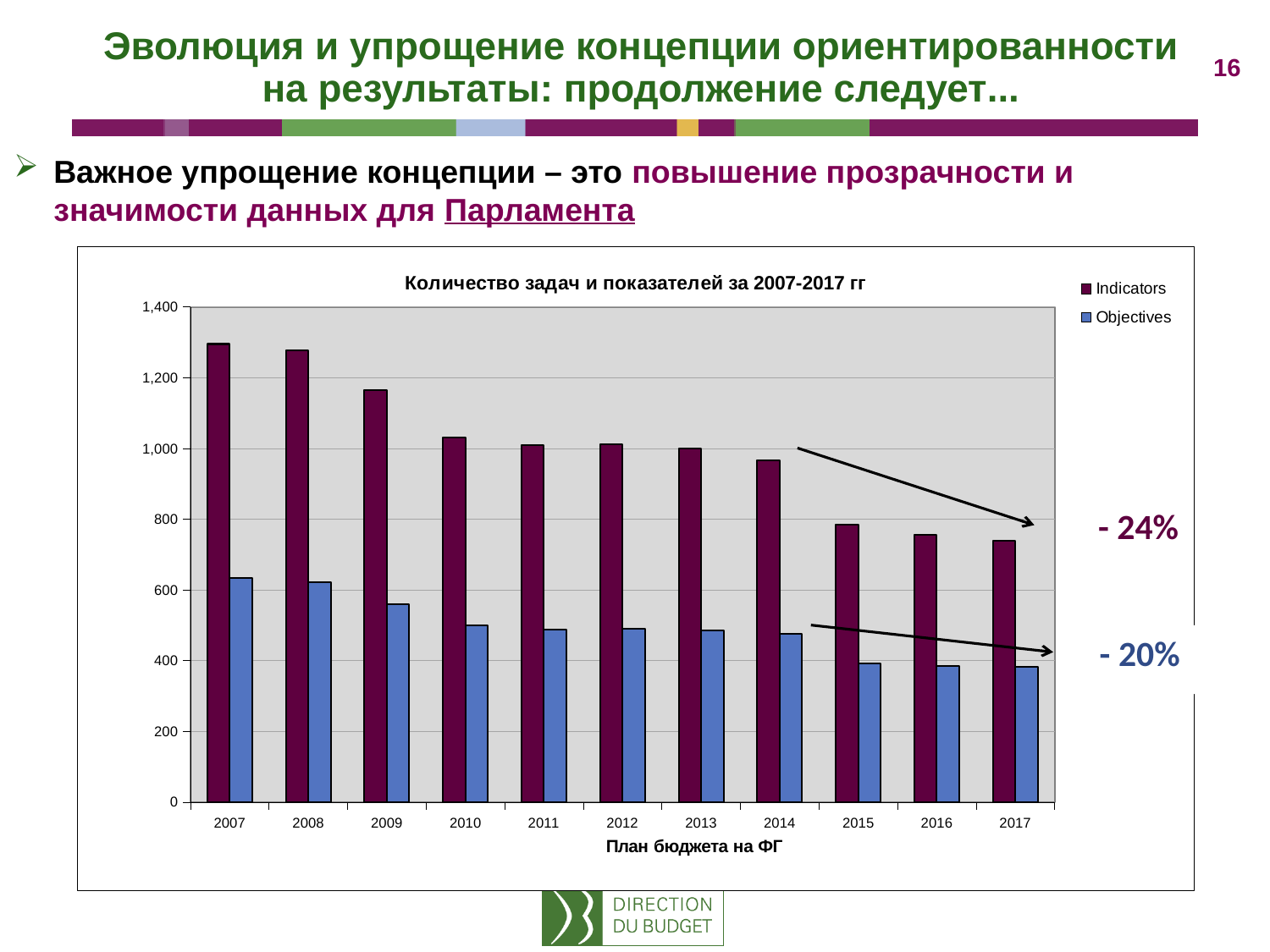
Is the Objectives value for 2007 greater or less than 600? greater Is the Indicators value for 2007 greater or less than 1,200? greater What type of chart is shown on the slide? bar chart Is the Objectives value for 2009 greater or less than 400? greater Which is larger, the Indicators value for 2009 or for 2010? 2009 What is the title of the chart? Количество задач и показателей за 2007-2017 гг What are the two series named in the legend? Indicators and Objectives How many years are shown on the x axis? 11 Do the Indicators values generally rise or fall from 2007 to 2017? fall How many series does the legend list? 2